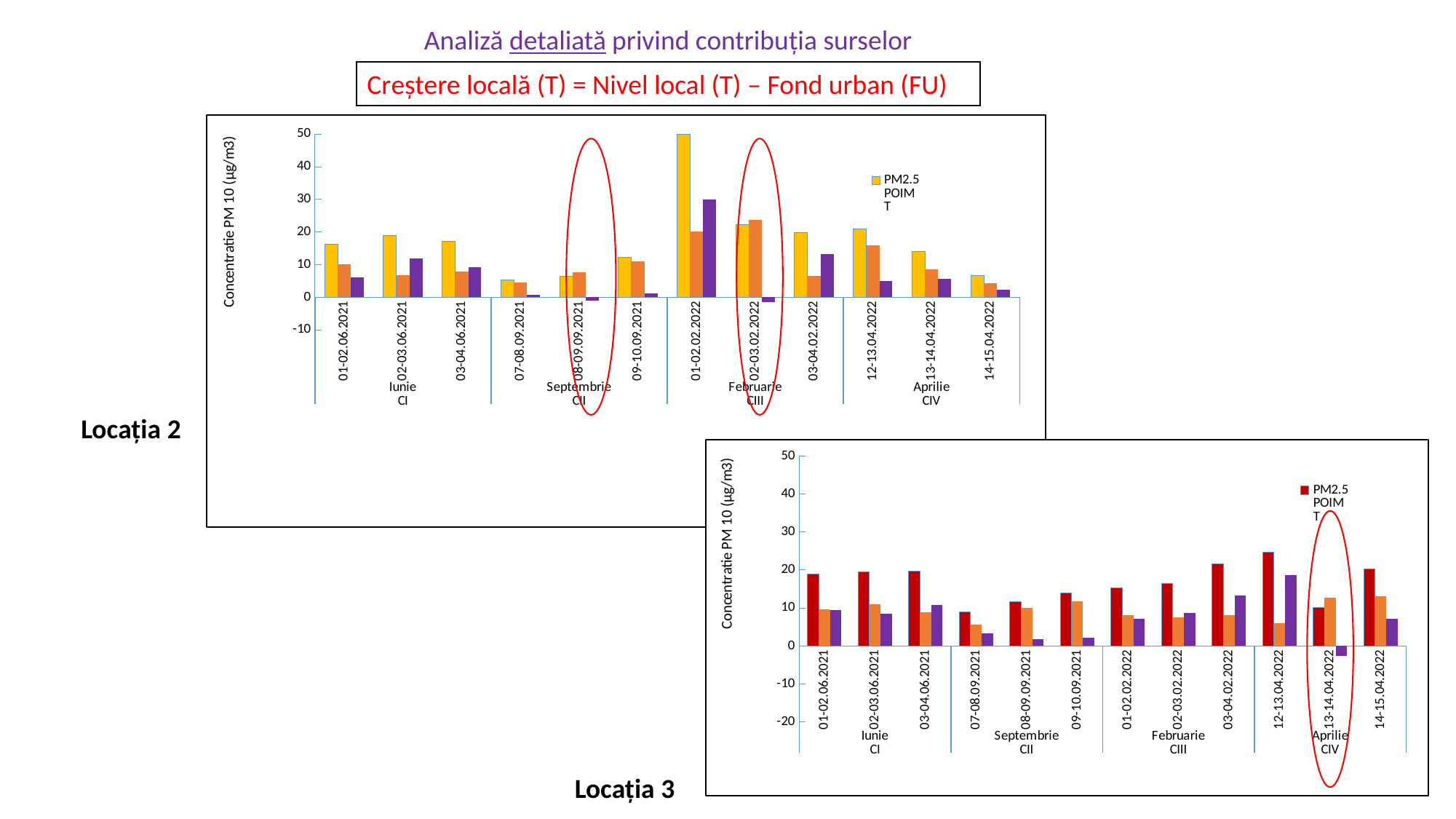
What is the y-axis title of the Locația 3 chart? Concentratie PM 10 (µg/m3) In the Locația 2 chart, which date has the highest PM2.5 value? 01-02.02.2022 How many date categories are plotted on the x axis of the Locația 2 chart? 12 What kind of chart is the Locația 2 chart? bar chart In the Locația 3 chart, which date has the highest PM2.5 value? 12-13.04.2022